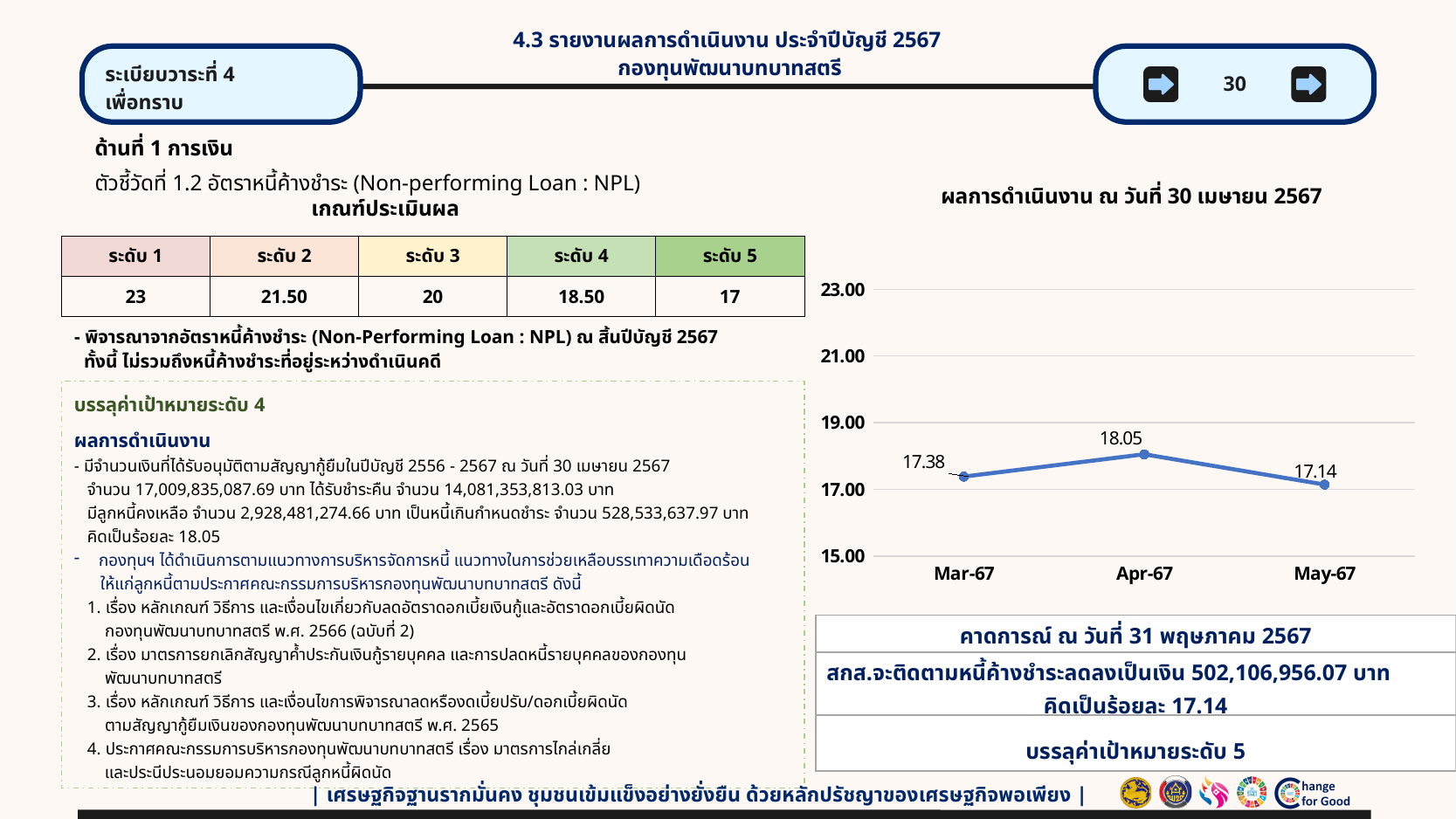
What is the value for Apr-67 in the line chart? 18.05 Is the value for Apr-67 greater or less than 19.00? less Which month has the lowest value in the line chart? May-67 What is the difference between the values for Apr-67 and Mar-67? 0.67 What is the value for Mar-67 in the line chart? 17.38 What type of chart is shown on the slide? line chart Which month has the highest value in the line chart? Apr-67 What is the difference between the values for Apr-67 and May-67? 0.91 How many data points are plotted in the line chart? 3 What is the value for May-67 in the line chart? 17.14 Which is larger, the value for Mar-67 or the value for May-67? Mar-67 Does the value rise or fall from Apr-67 to May-67? fall